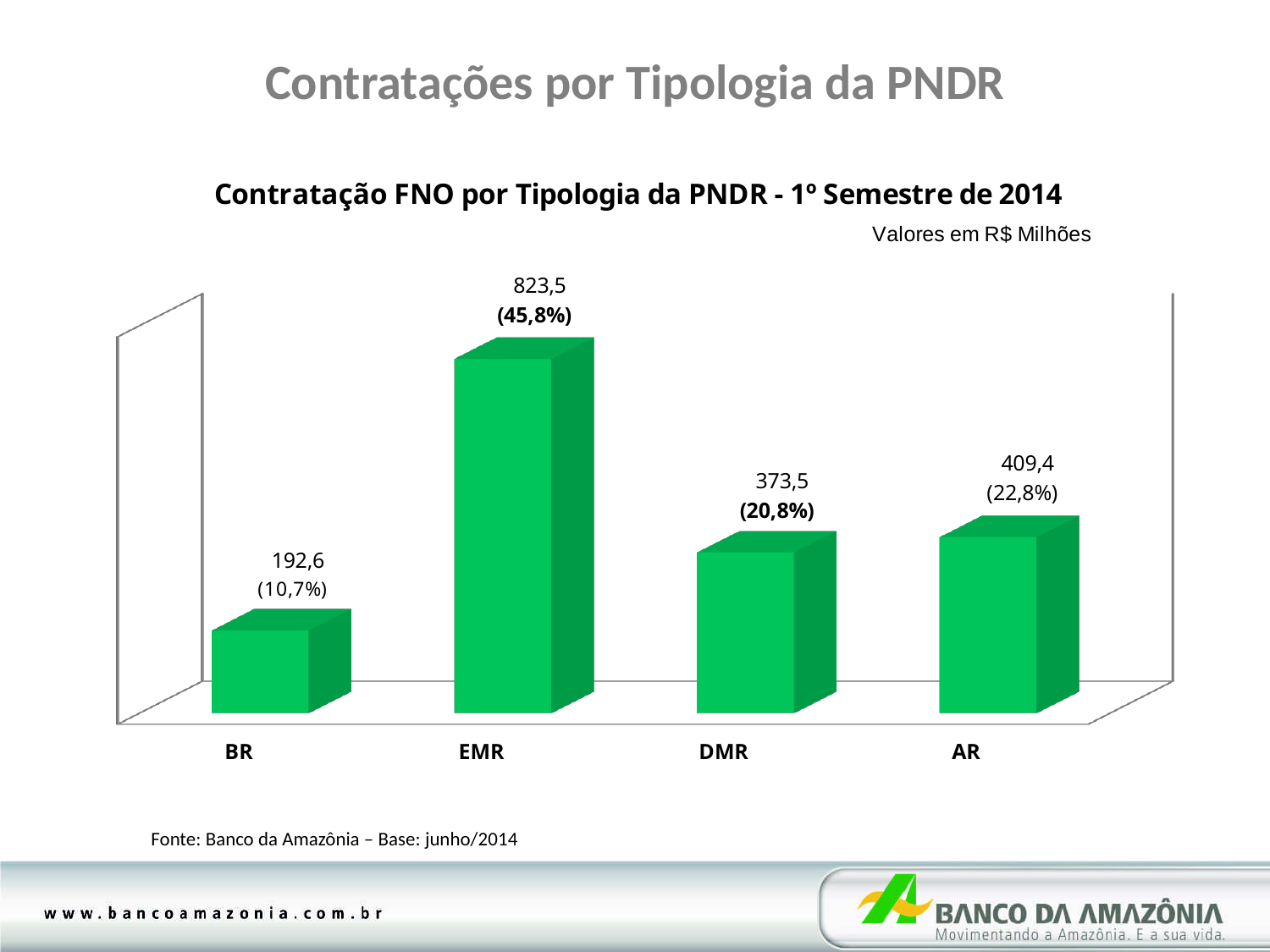
Which category has the highest value? EMR What unit is stated for the values in the chart? R$ Milhões What kind of chart is shown on the slide? Bar chart How many categories are shown in the chart? 4 What is the difference between the values for EMR and BR? 630,9 What percentage share is shown for DMR? 20,8% Which is larger, the value for AR or the value for DMR? AR What is the value for AR? 409,4 What is the value for BR? 192,6 What is the value for EMR? 823,5 Which category has the lowest value? BR What is the difference between the values for AR and DMR? 35,9